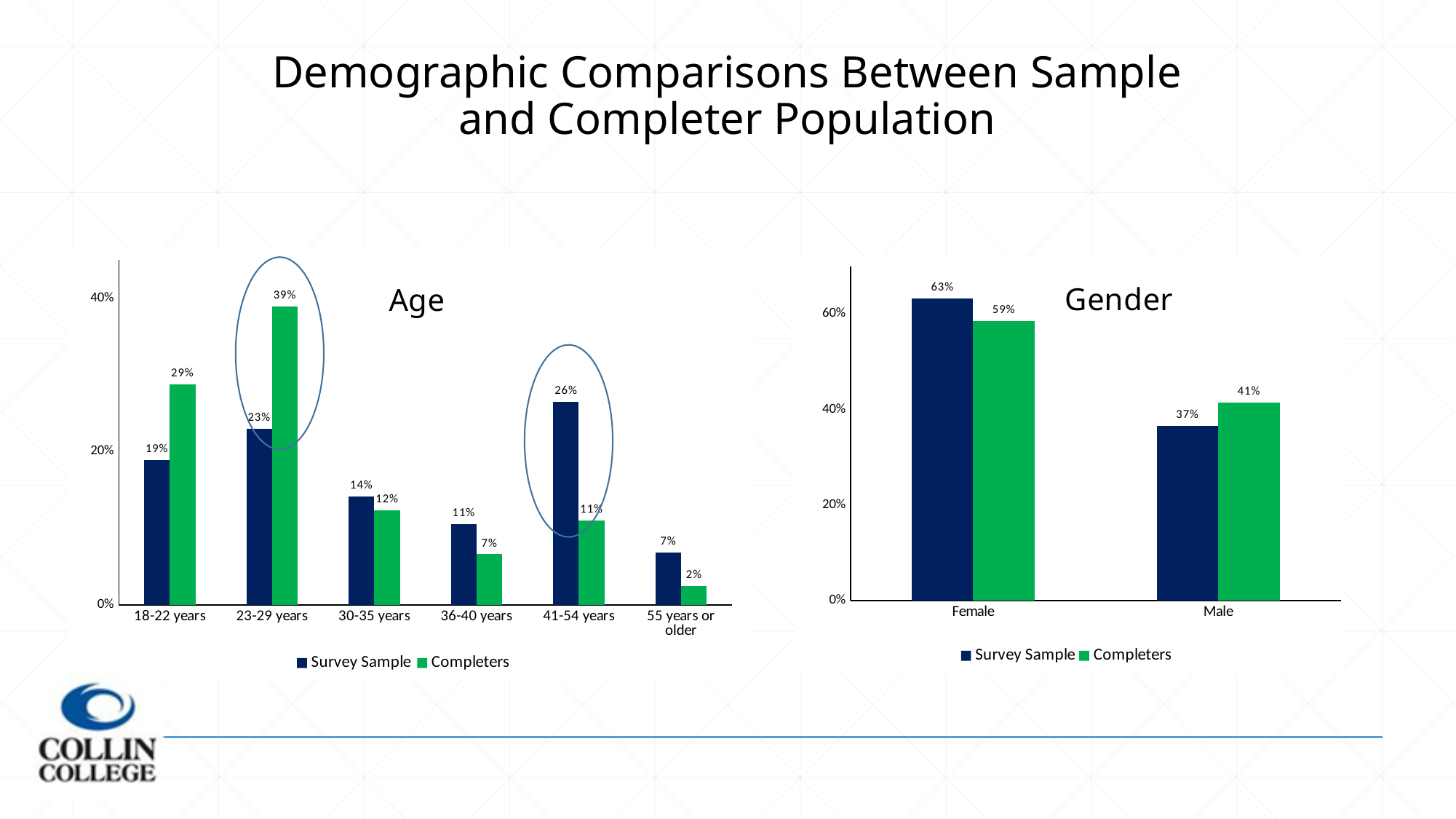
In the Age chart, which age group has the lowest Survey Sample value? 55 years or older In the Age chart, which series is shown in green? Completers What kind of chart is the Gender chart? Bar chart How many series does the legend of the Gender chart list? 2 In the Gender chart, what is the difference between the Survey Sample and Completers values for Male? 4% In the Age chart, what is the difference between the Completers and Survey Sample values for 23-29 years? 16% In the Age chart, which is larger for 41-54 years, Survey Sample or Completers? Survey Sample In the Age chart, which age group has the highest Completers value? 23-29 years In the Age chart, what is the Survey Sample value for 23-29 years? 23% In the Age chart, what is the Completers value for 41-54 years? 11% How many age groups are shown in the Age chart? 6 In the Gender chart, what is the Survey Sample value for Female? 63%